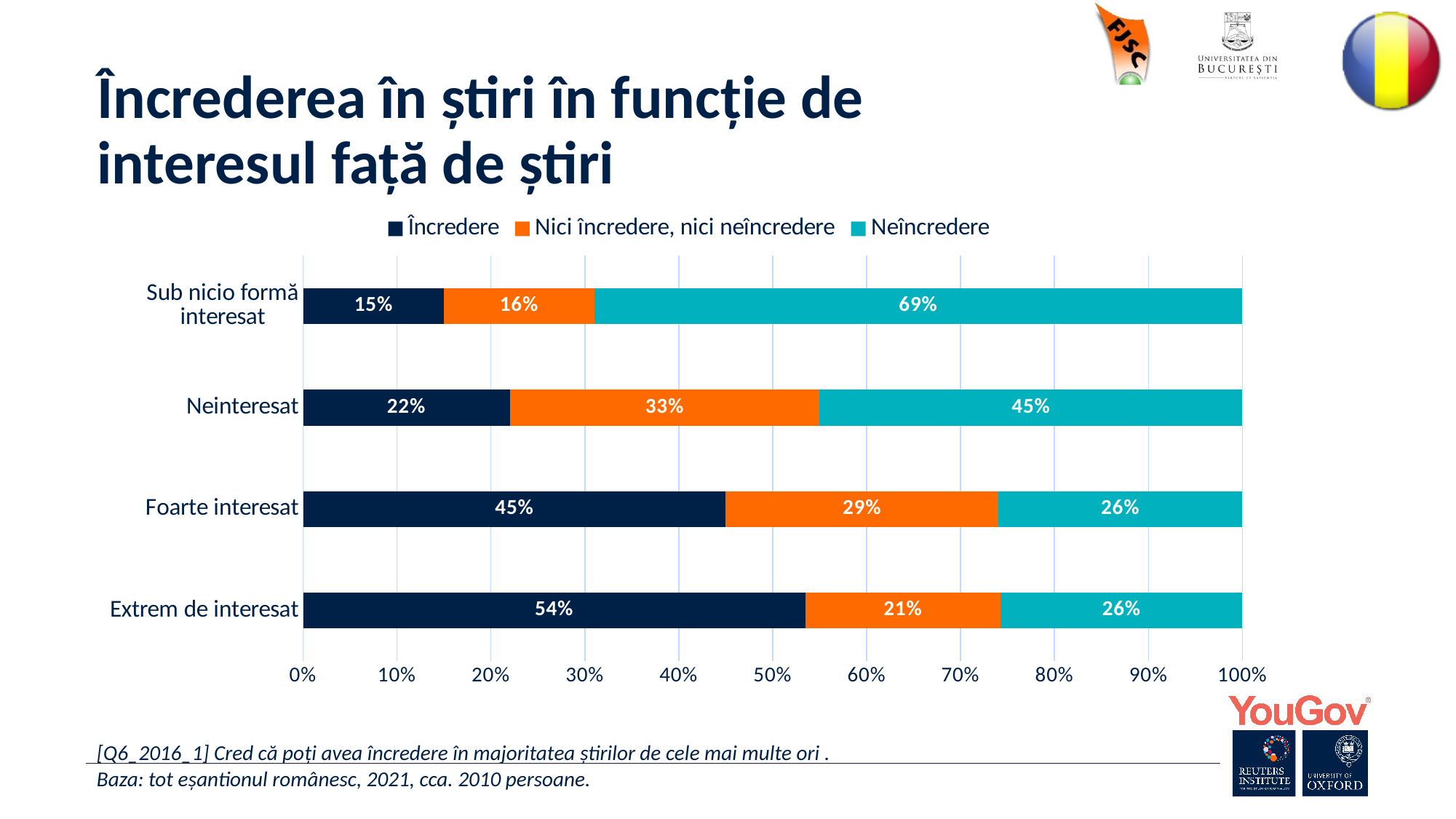
What is the value for Neîncredere in the Sub nicio formă interesat category? 69% What is the difference between the Încredere values for Extrem de interesat and Sub nicio formă interesat? 39 percentage points Which category has the lowest value for Neîncredere? Foarte interesat and Extrem de interesat (both 26%) What is the value for Încredere in the Extrem de interesat category? 54% What kind of chart is shown on the slide? Stacked bar chart Which category has the highest value for Încredere? Extrem de interesat Which is larger: the Neîncredere value for Neinteresat or the Neîncredere value for Foarte interesat? Neinteresat How many series does the legend list? 3 Which colour represents Neîncredere in the chart? Teal What is the value for Nici încredere, nici neîncredere in the Neinteresat category? 33% Is the Încredere value for Foarte interesat greater or less than 40%? greater How many categories are shown on the y axis? 4